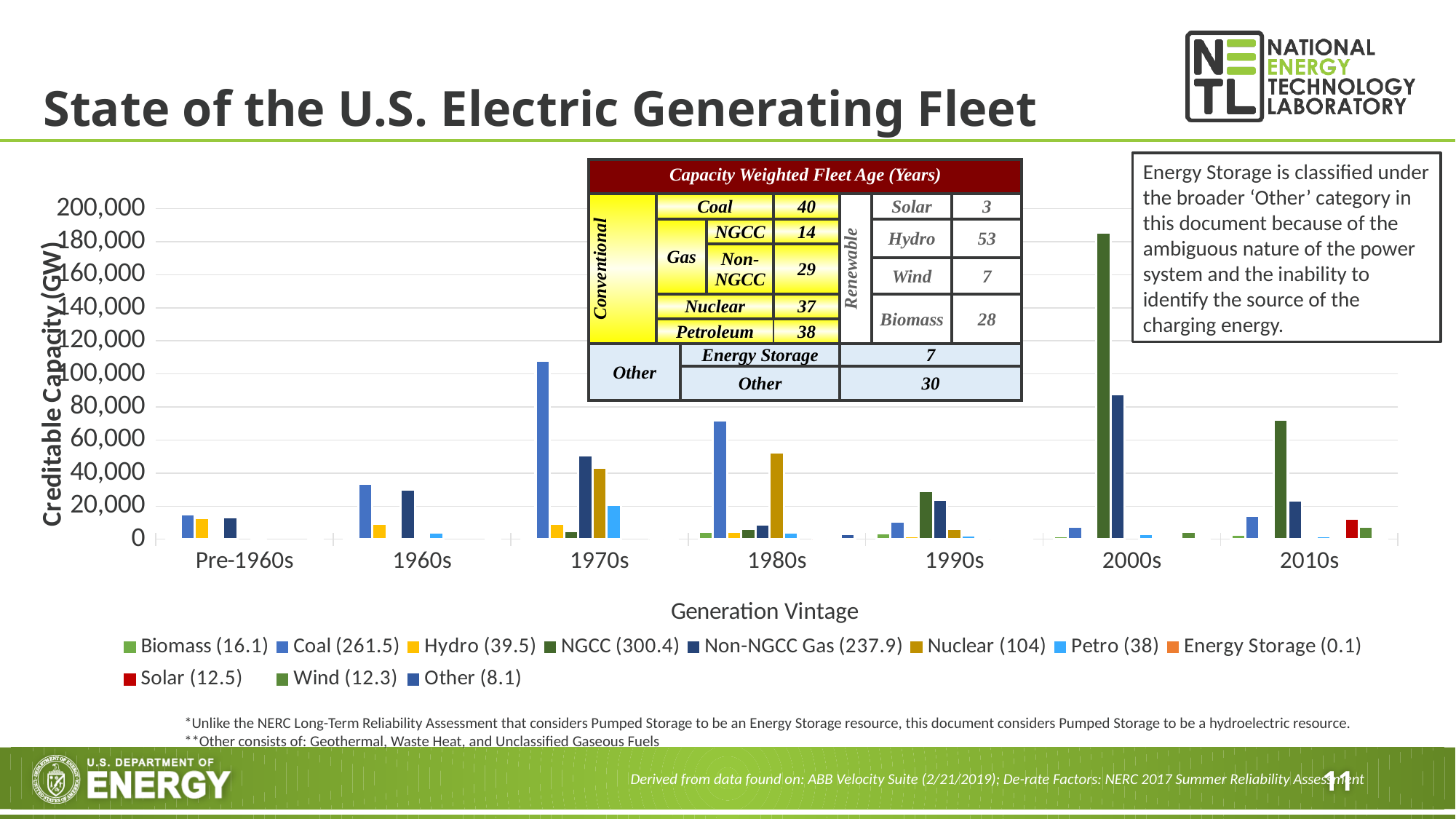
How many series does the chart legend list? 11 Which series has the tallest bar in the 2000s vintage? NGCC What is the title of the chart's vertical axis? Creditable Capacity (GW) Is the Coal value for the 1970s greater or less than 80,000? greater Is the NGCC value for the 2000s greater or less than 160,000? greater Which is larger, the Coal value for the 1970s or the Coal value for the 1980s? 1970s What kind of chart is shown on the slide? bar chart Is the Nuclear value for the 1980s greater or less than 40,000? greater Which is larger, the Nuclear value for the 1970s or the Nuclear value for the 1980s? 1980s In which generation vintage is the Coal bar highest? 1970s How many generation vintage categories are shown on the x axis? 7 Which generation vintage has the tallest bar in the chart? 2000s